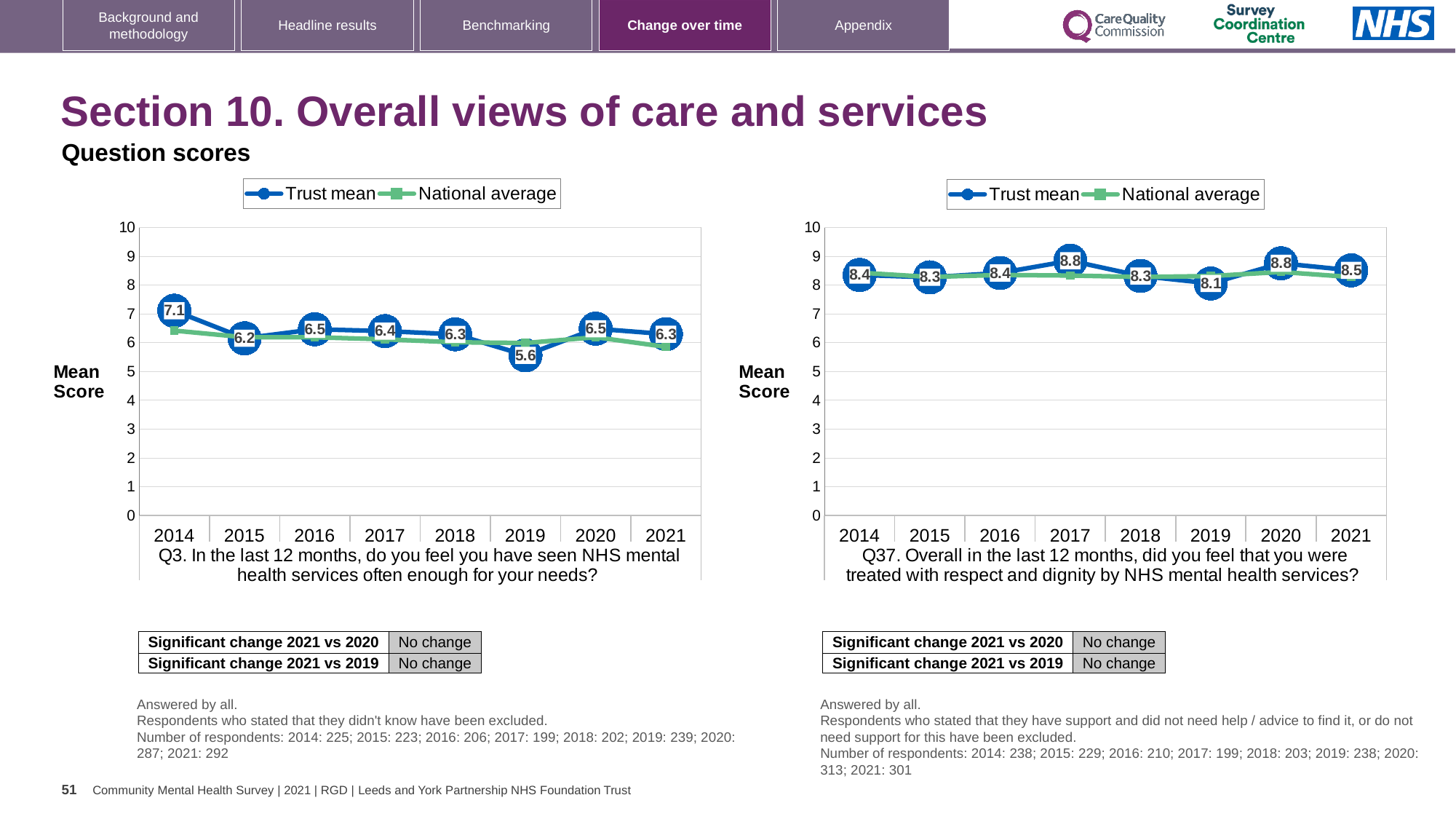
On the left chart (Q3), which year has the highest Trust mean? 2014 On the left chart (Q3), what is the difference between the Trust mean in 2014 and in 2021? 0.8 On the left chart (Q3), what is the Trust mean for 2014? 7.1 On the right chart (Q37), what is the Trust mean for 2021? 8.5 On the right chart (Q37), how many years are shown on the x axis? 8 On the left chart (Q3), which year has the lowest Trust mean? 2019 On the right chart (Q37), what is the Trust mean for 2017? 8.8 On the right chart (Q37), which year has the lowest Trust mean? 2019 On the left chart (Q3), what is the Trust mean for 2019? 5.6 How many series does the legend of the left chart (Q3) list? 2 What type of chart is the right chart (Q37)? Line chart On the right chart (Q37), is the Trust mean for 2020 larger or smaller than the Trust mean for 2019? larger